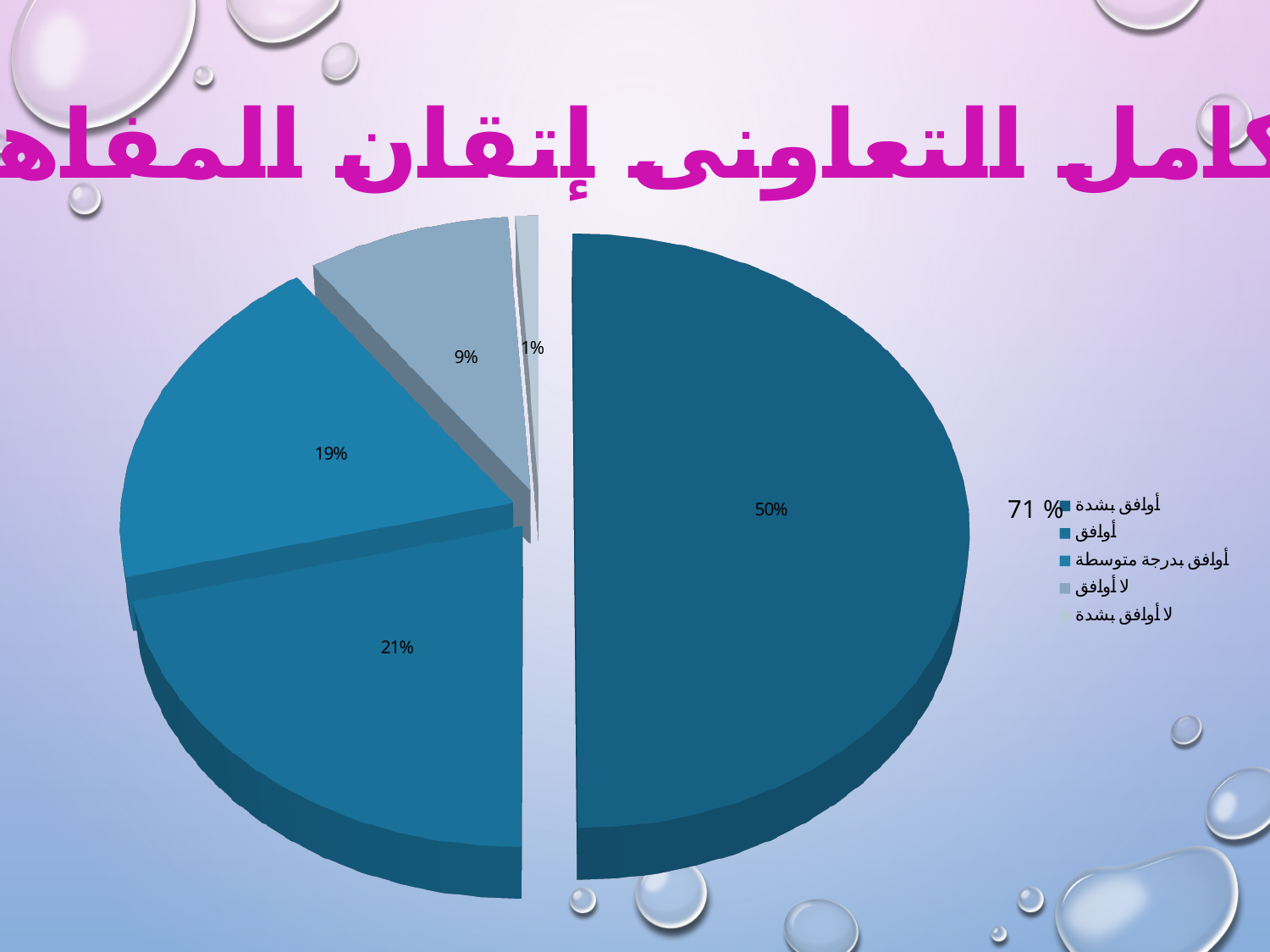
What percentage is shown for the largest slice of the pie chart? 50% What percentage is shown for the smallest slice of the pie chart? 1% What share of the pie does the slice labelled أوافق بشدة represent? 50% What kind of chart is shown on the slide? pie chart What share of the pie does the slice labelled أوافق represent? 21% How many slices does the pie chart have? 5 Which slice is larger in the pie chart, the one labelled 19% or the one labelled 9%? 19% What is the combined share of the 9% and 1% slices of the pie chart? 10% How many entries does the legend of the pie chart list? 5 What share of the pie does the slice labelled لا أوافق represent? 9% Which legend entry is listed first in the pie chart's legend? أوافق بشدة What is the difference between the 21% slice and the 19% slice of the pie chart? 2%